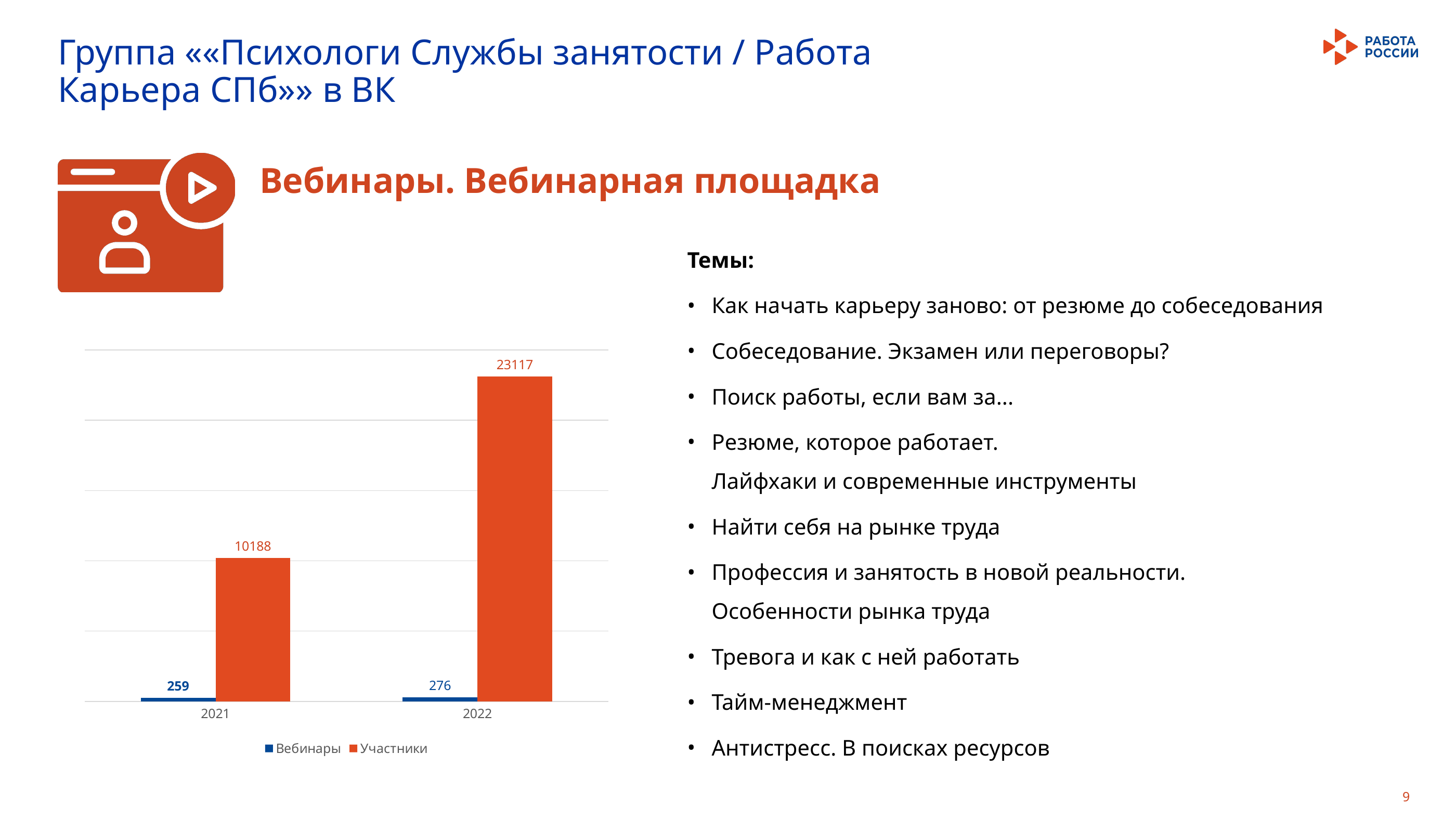
What is the value for Участники in 2022? 23117 What is the value for Участники in 2021? 10188 What is the value for Вебинары in 2022? 276 Which is larger: Участники in 2021 or Участники in 2022? 2022 What kind of chart is shown on the slide? bar chart What is the value for Вебинары in 2021? 259 Which series is shown in orange in the chart legend? Участники What is the difference between the Участники values for 2022 and 2021? 12929 How many years are shown on the x axis of the chart? 2 How many series does the chart legend list? 2 What is the difference between the Вебинары values for 2022 and 2021? 17 In which year is the value for Участники highest? 2022